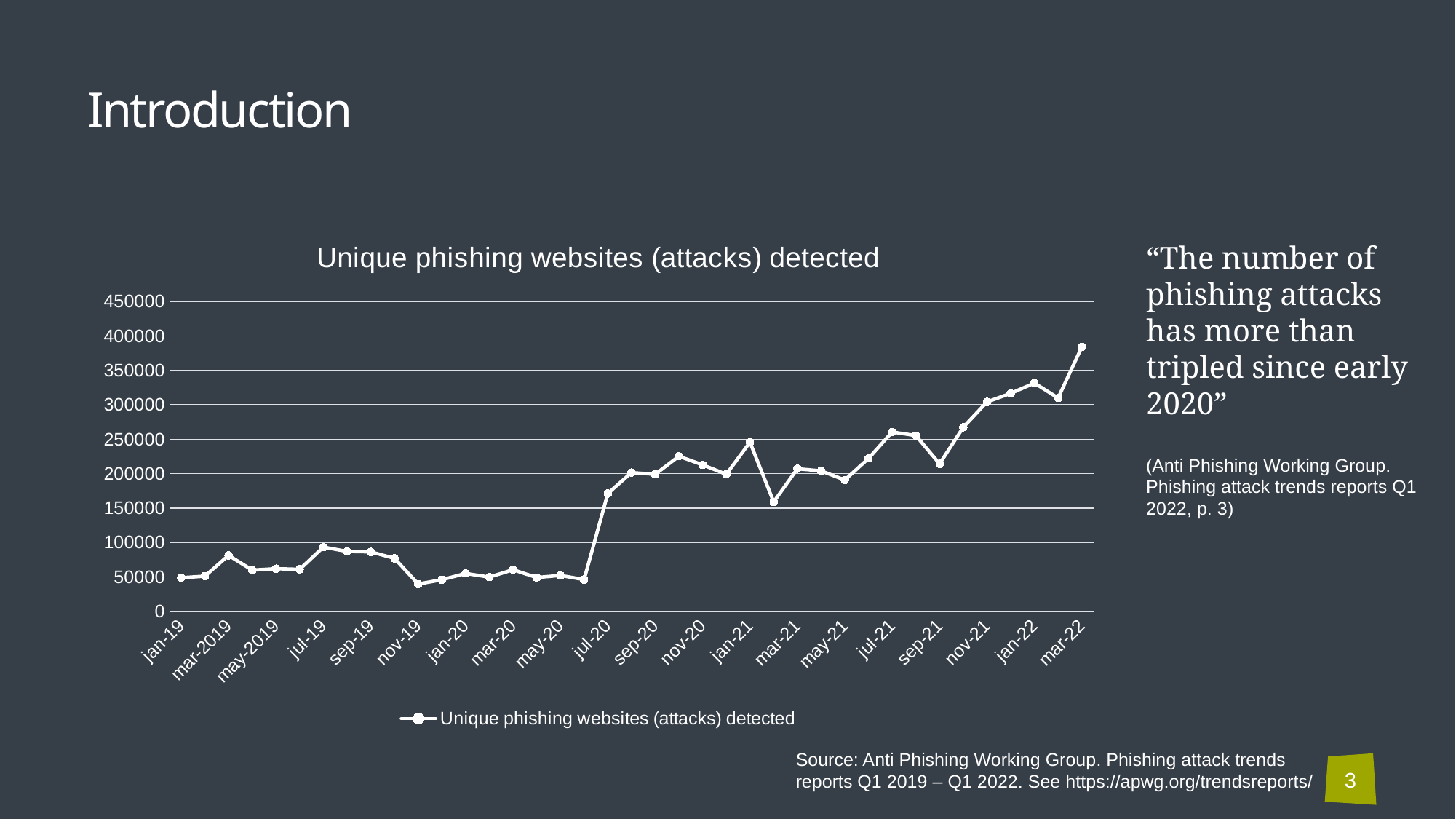
Is the value for jul-20 greater or less than 150000? greater Which is larger, the value for mar-22 or the value for jan-19? mar-22 How many series does the chart legend list? 1 Is the value for mar-22 greater or less than 350000? greater Is the value for nov-19 greater or less than 50000? less What kind of chart is shown on the slide? line chart What is the title of the chart? Unique phishing websites (attacks) detected Overall, do the values rise or fall from jan-19 to mar-22? rise Which is larger, the value for jul-20 or the value for may-20? jul-20 Which month has the highest number of unique phishing websites detected? mar-22